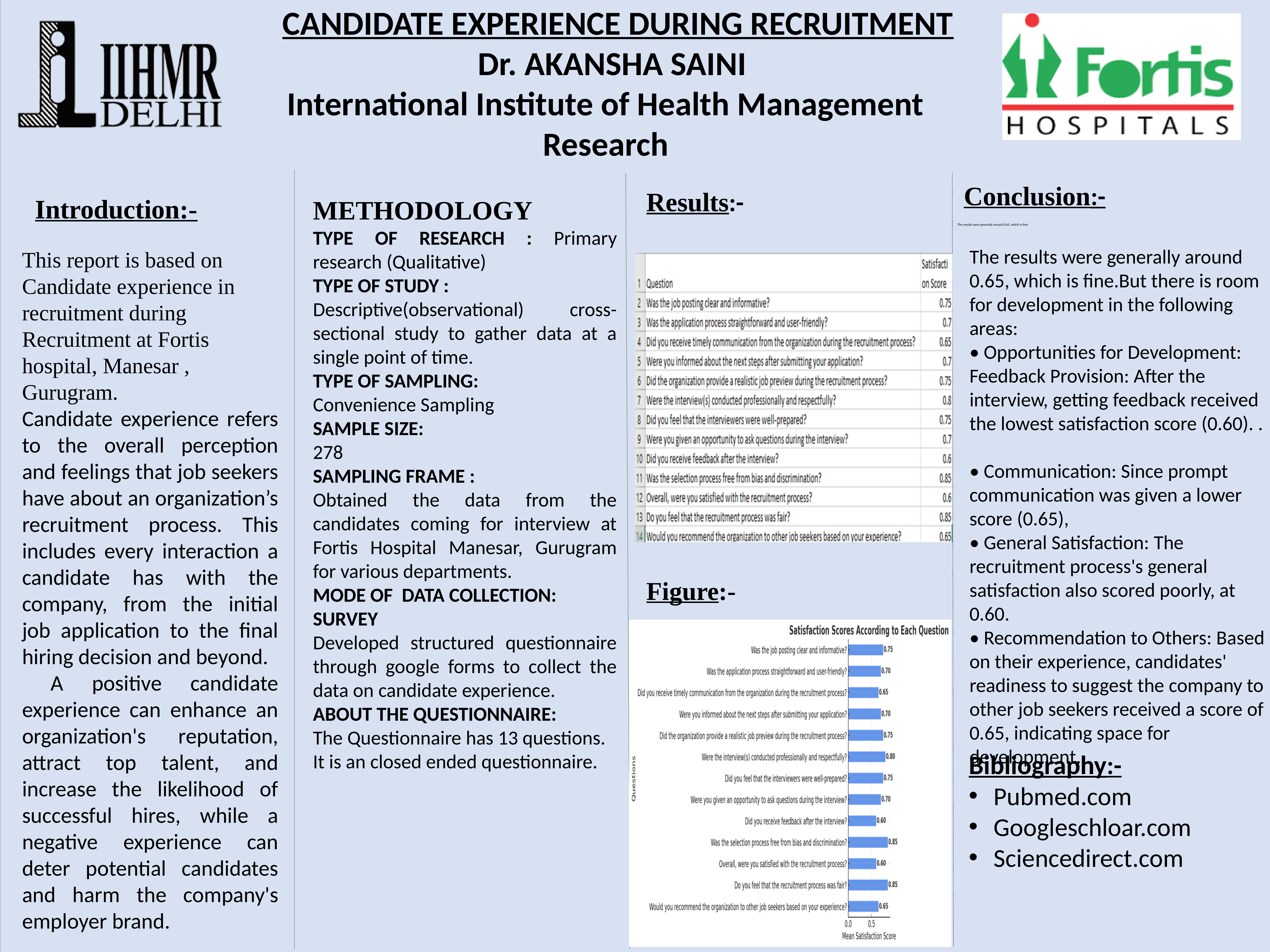
In the Satisfaction Scores chart, what is the value for "Did you receive feedback after the interview?" 0.60 What is the highest satisfaction score shown in the chart? 0.85 What is the lowest satisfaction score shown in the chart? 0.60 What is the x-axis label of the Satisfaction Scores chart? Mean Satisfaction Score How many bars does the Satisfaction Scores chart show? 13 What is the title of the chart on the slide? Satisfaction Scores According to Each Question In the Satisfaction Scores chart, what is the value for "Was the job posting clear and informative?" 0.75 In the Satisfaction Scores chart, what is the value for "Were the interview(s) conducted professionally and respectfully?" 0.80 In the Satisfaction Scores chart, what is the value for "Would you recommend the organization to other job seekers based on your experience?" 0.65 In the Satisfaction Scores chart, what is the difference between the value for "Was the selection process free from bias and discrimination?" and the value for "Overall, were you satisfied with the recruitment process?" 0.25 What kind of chart is shown under the Figure heading? bar chart In the Satisfaction Scores chart, which is larger: the value for "Were the interview(s) conducted professionally and respectfully?" or the value for "Did you receive timely communication from the organization during the recruitment process?" Were the interview(s) conducted professionally and respectfully?